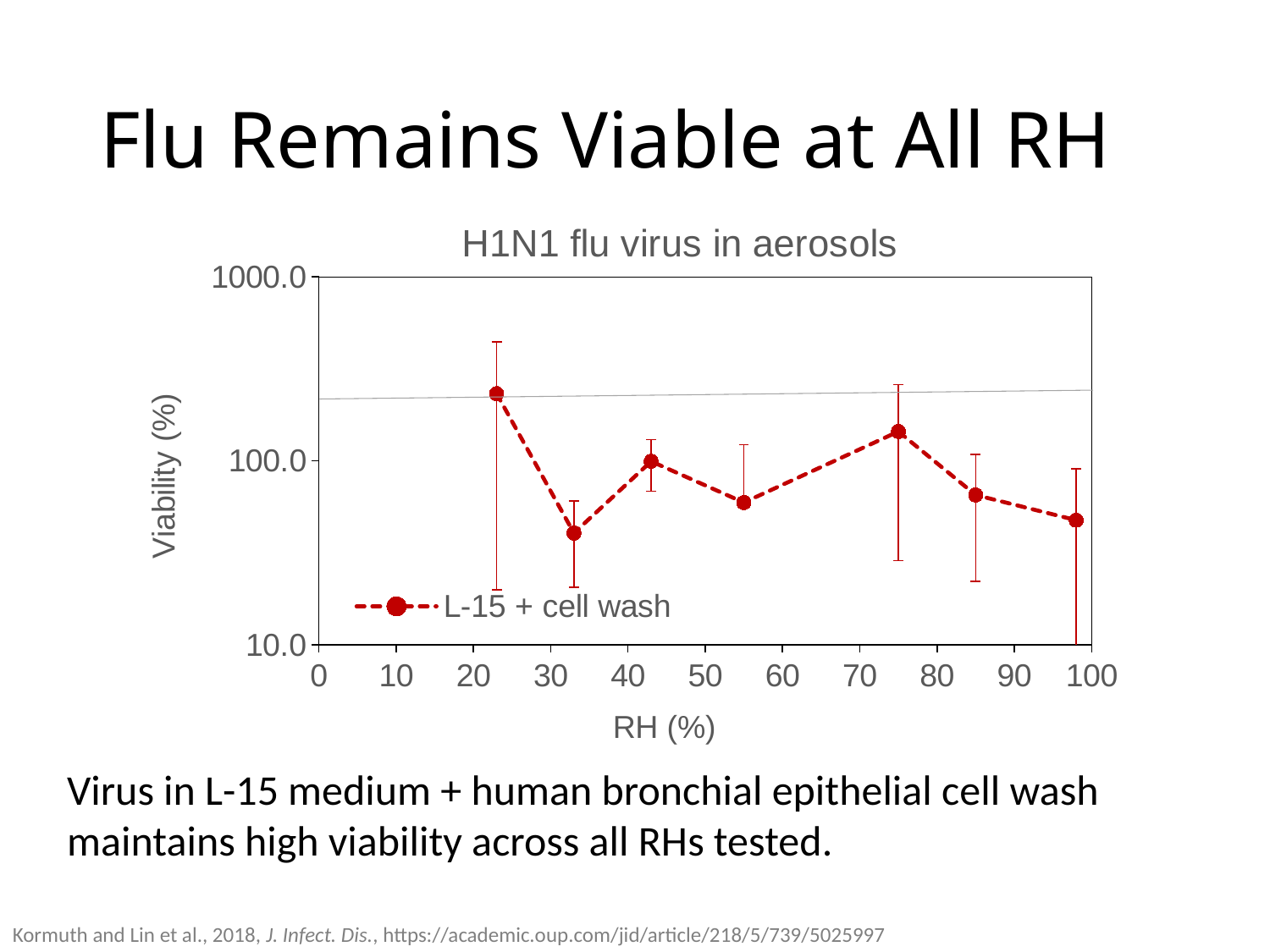
What kind of chart is shown on the slide? line chart How many data points are plotted on the line? 7 What is the title of the chart? H1N1 flu virus in aerosols How many series does the chart legend list? 1 Is the viability value for the point near RH 75% greater or less than 100.0? greater Between the point near RH 75% and the point near RH 98%, do the viability values rise or fall? fall Is the viability value for the point near RH 23% greater or less than 100.0? greater Is the viability value for the point near RH 33% greater or less than 100.0? less Which point has the larger viability value: the one near RH 75% or the one near RH 85%? RH 75% What is the name of the series shown in the legend? L-15 + cell wash